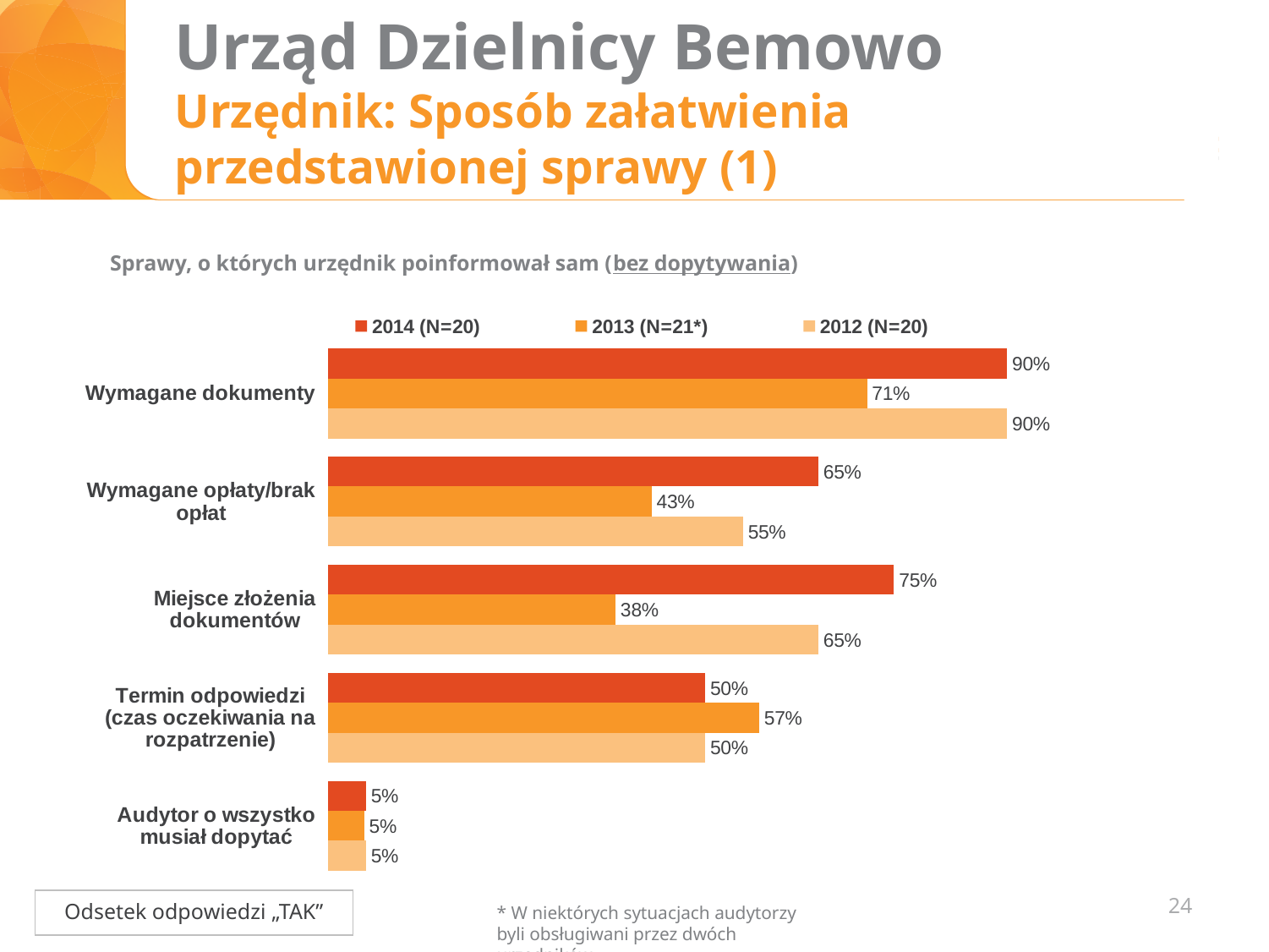
For Wymagane opłaty/brak opłat, which is larger: the 2014 (N=20) value or the 2012 (N=20) value? 2014 (N=20) Which category has the highest value in the 2013 (N=21*) series? Wymagane dokumenty What is the value for Wymagane opłaty/brak opłat in the 2013 (N=21*) series? 43% What is the subtitle text shown above the chart? Sprawy, o których urzędnik poinformował sam (bez dopytywania) What is the value for Termin odpowiedzi (czas oczekiwania na rozpatrzenie) in the 2013 (N=21*) series? 57% Which category has the lowest value in the 2014 (N=20) series? Audytor o wszystko musiał dopytać What is the value for Miejsce złożenia dokumentów in the 2012 (N=20) series? 65% What kind of chart is shown on the slide? Bar chart What is the difference between the 2014 (N=20) and 2013 (N=21*) values for Miejsce złożenia dokumentów? 37% How many series does the legend list? 3 How many categories are shown on the chart? 5 What is the value for Wymagane dokumenty in the 2014 (N=20) series? 90%